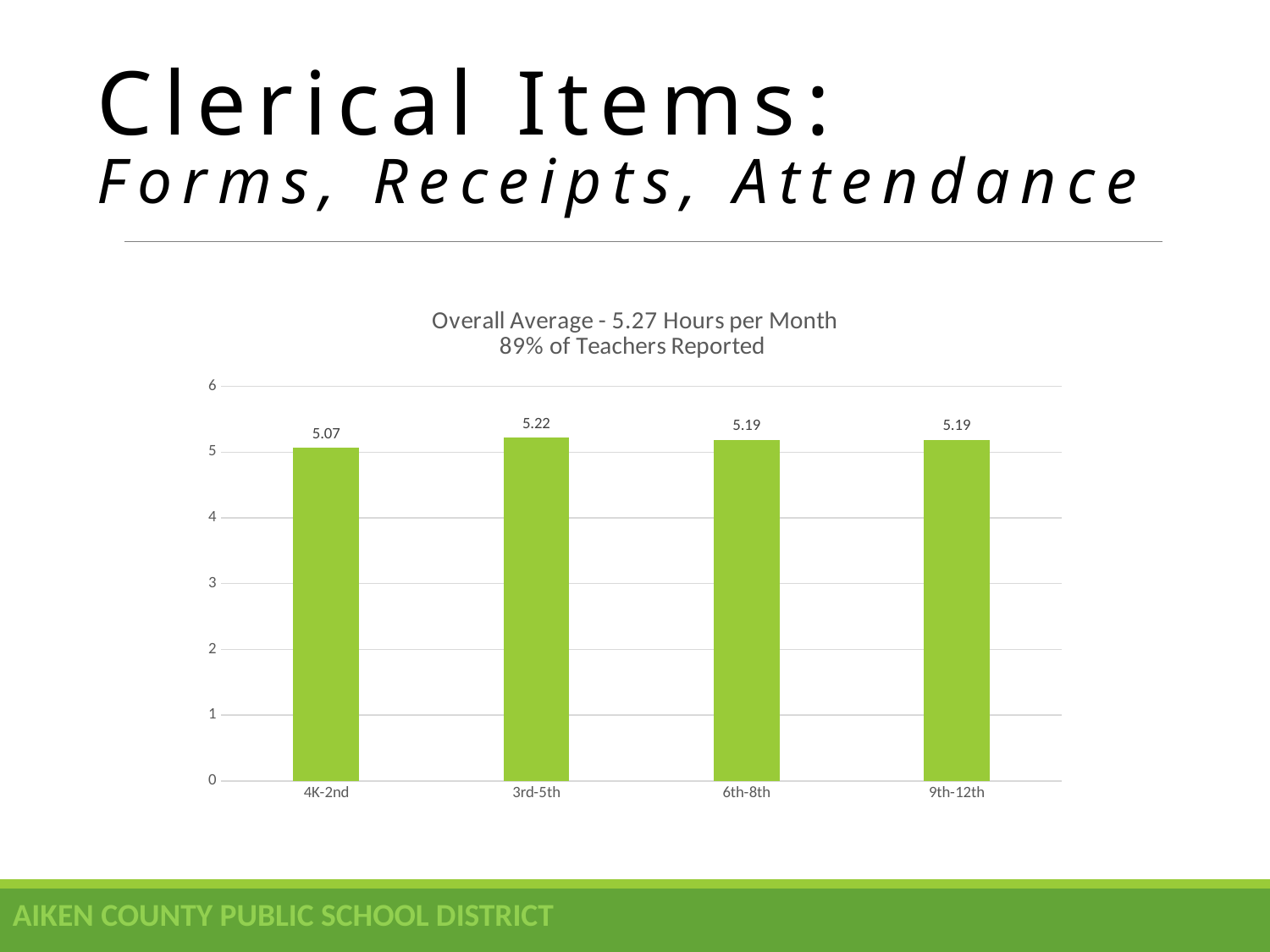
What kind of chart is shown on the slide? bar chart What is the value for 9th-12th? 5.19 What is the value for 4K-2nd? 5.07 What is the difference between the values for 3rd-5th and 4K-2nd? 0.15 Which is larger, the value for 3rd-5th or the value for 4K-2nd? 3rd-5th Which grade band has the lowest value? 4K-2nd What overall average is stated in the chart title? 5.27 Hours per Month How many grade bands are shown on the x axis? 4 Which grade band has the highest value? 3rd-5th What is the value for 6th-8th? 5.19 What is the value for 3rd-5th? 5.22 Is the value for 6th-8th greater or less than 5? greater